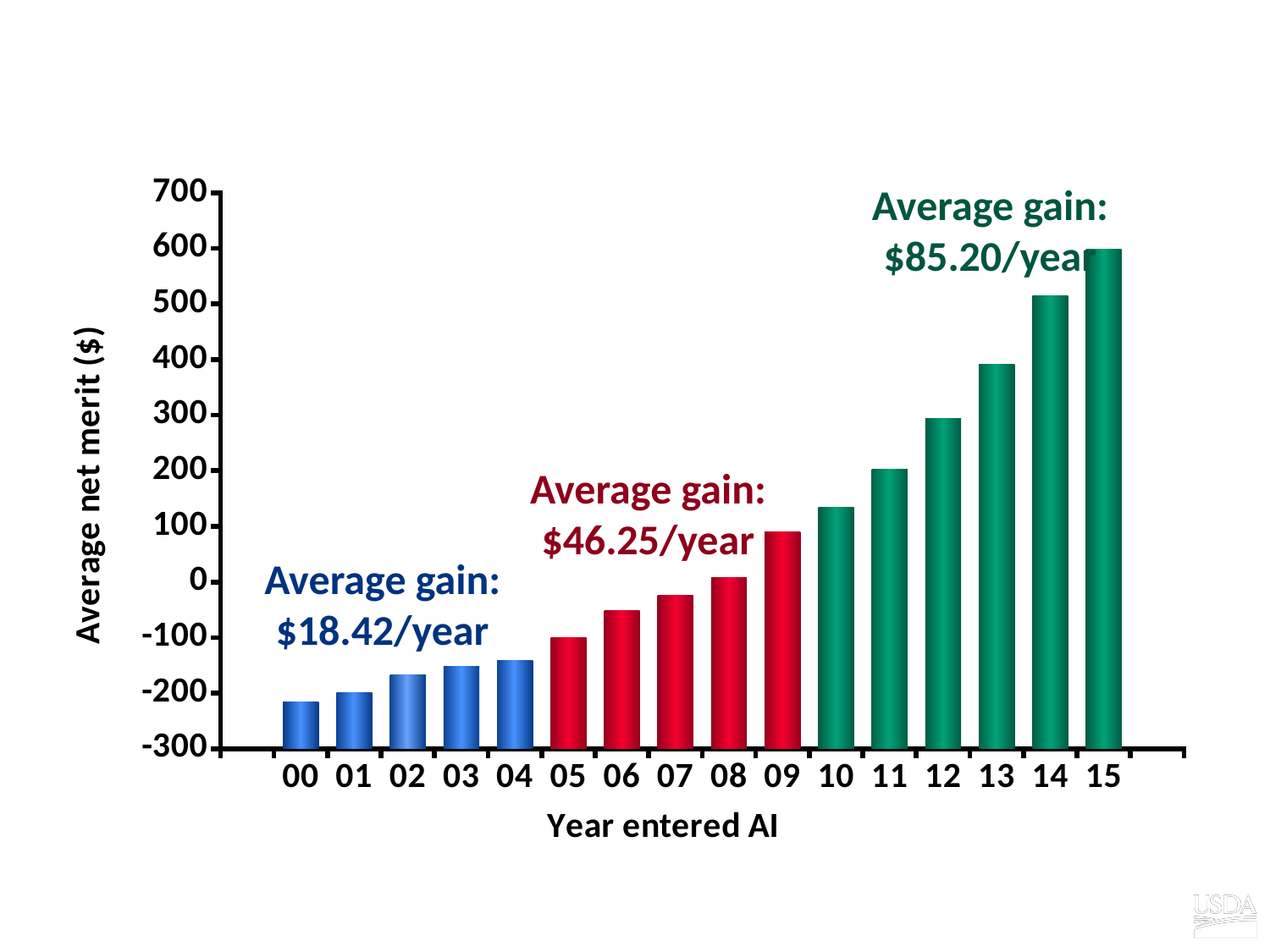
Is the average net merit for year 15 greater or less than 500? greater Is the average net merit for year 07 greater or less than 0? less Which year entered AI has the lowest average net merit? 00 Do the average net merit values rise or fall as the year entered AI increases from 00 to 15? rise Is the average net merit for year 12 greater or less than 200? greater Which has a larger average net merit, year 09 or year 13? 13 How many years (bars) are plotted on the x axis? 16 What average gain per year is stated for the green bars (years 10 to 15)? $85.20/year Which year entered AI has the highest average net merit? 15 What kind of chart is shown on the slide? bar chart What is the title of the y axis? Average net merit ($)